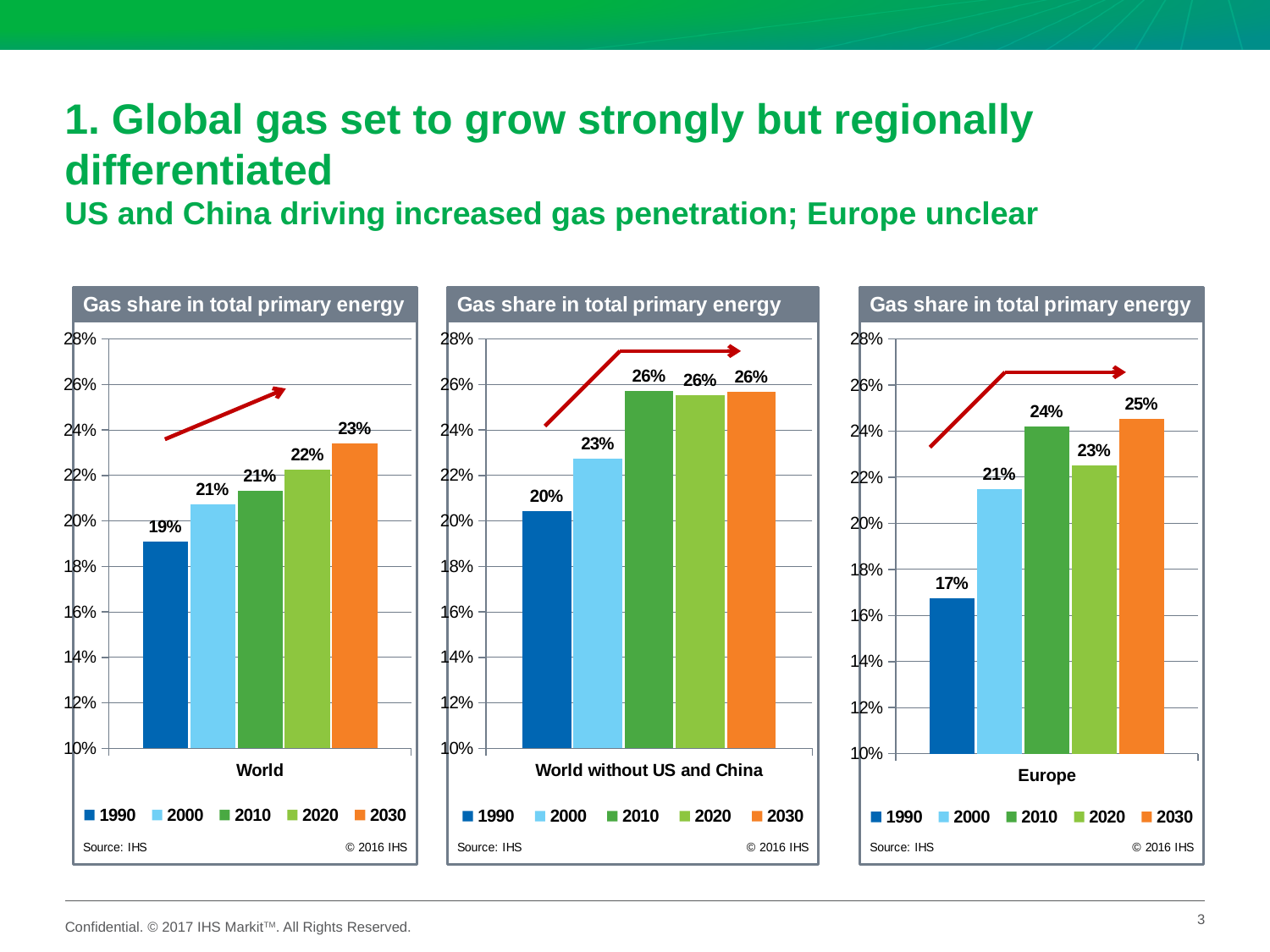
In the left chart (World), which year has the highest gas share? 2030 In the right chart (Europe), what is the difference between the 2030 value and the 1990 value? 8% In the middle chart (World without US and China), what is the value for 2000? 23% In the right chart (Europe), which year has the lowest gas share? 1990 In the middle chart (World without US and China), what is the difference between the 2010 value and the 1990 value? 6% In the left chart (World), do the values rise or fall from 1990 to 2030? Rise What is the title of the right chart? Gas share in total primary energy How many series does the legend of the left chart (World) list? 5 In the right chart (Europe), what is the value for 2020? 23% In the left chart (World), what is the gas share in total primary energy for 1990? 19% In the right chart (Europe), which is larger, the value for 2010 or the value for 2020? 2010 What kind of chart is the middle chart (World without US and China)? Bar chart